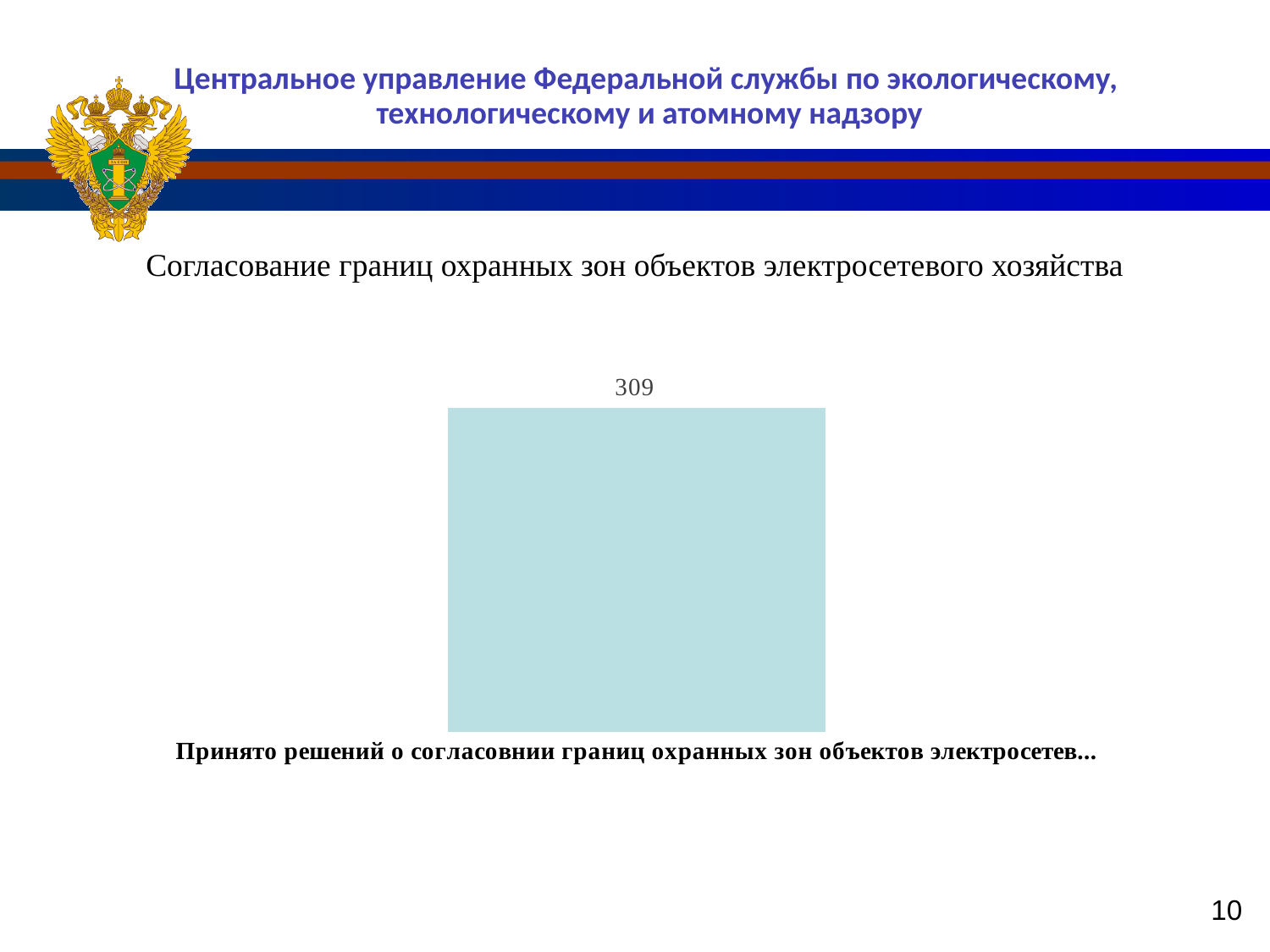
What kind of chart is shown on the slide? bar chart How many bars are plotted in the chart? 1 What is the value for the category "Принято решений о согласовнии границ охранных зон объектов электросетев..."? 309 What value is shown by the data label on the bar in the chart? 309 What colour is the bar in the chart? light blue Is the value of the bar in the chart greater or less than 300? greater What is the heading above the chart on the slide? Согласование границ охранных зон объектов электросетевого хозяйства